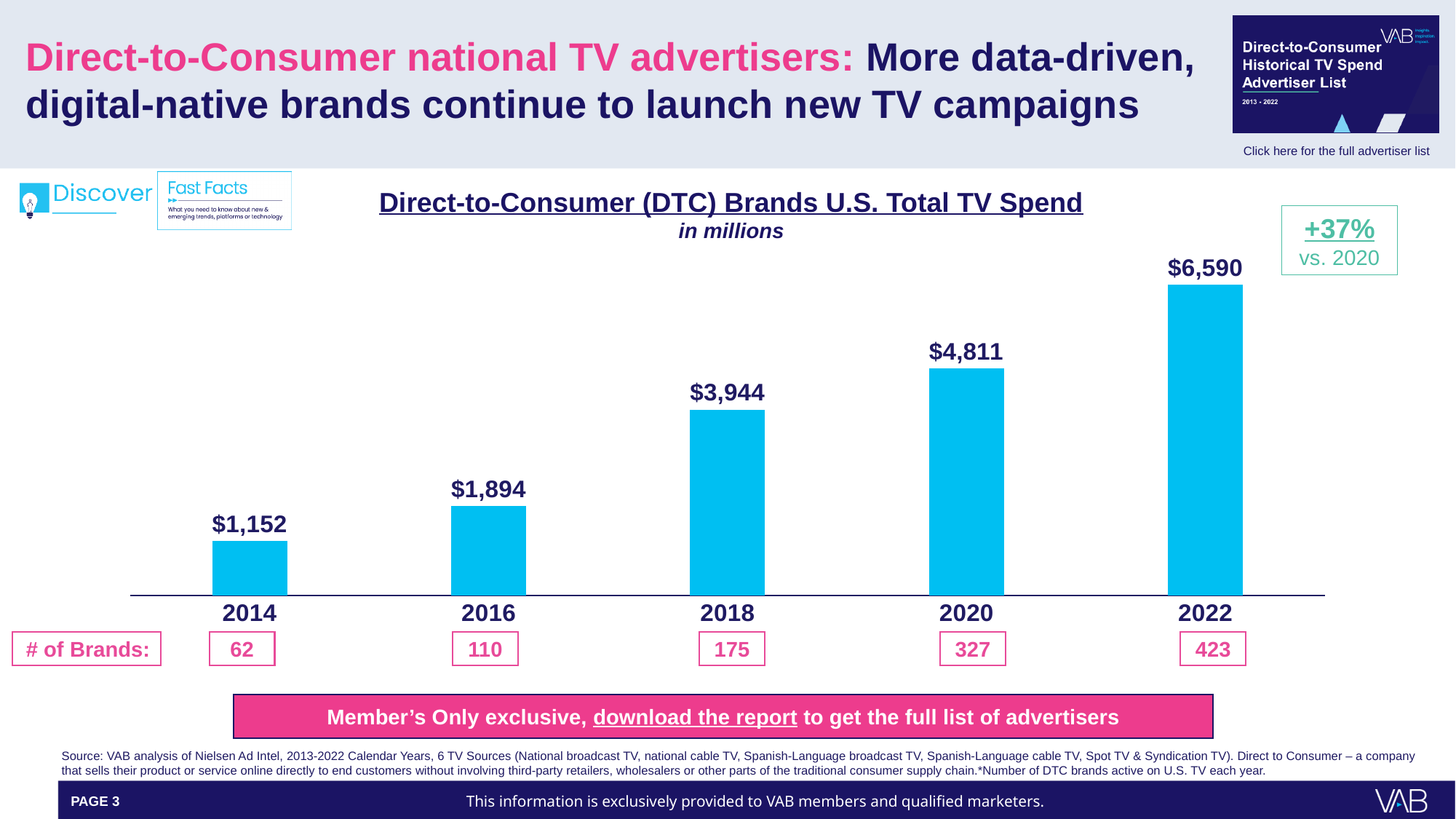
What is the difference in total TV spend between 2018 and 2016? $2,050 How many years are plotted on the chart? 5 What is the DTC brands U.S. total TV spend for 2018? $3,944 What is the DTC brands U.S. total TV spend for 2014? $1,152 Which year has a larger total TV spend, 2016 or 2018? 2018 What is the difference in total TV spend between 2022 and 2020? $1,779 Which year has the highest total TV spend? 2022 How many DTC brands are listed for 2022 in the '# of Brands' row? 423 What type of chart is shown on the slide? bar chart Do the total TV spend values rise or fall from 2014 to 2022? rise What is the DTC brands U.S. total TV spend for 2022? $6,590 Which year has the lowest total TV spend? 2014